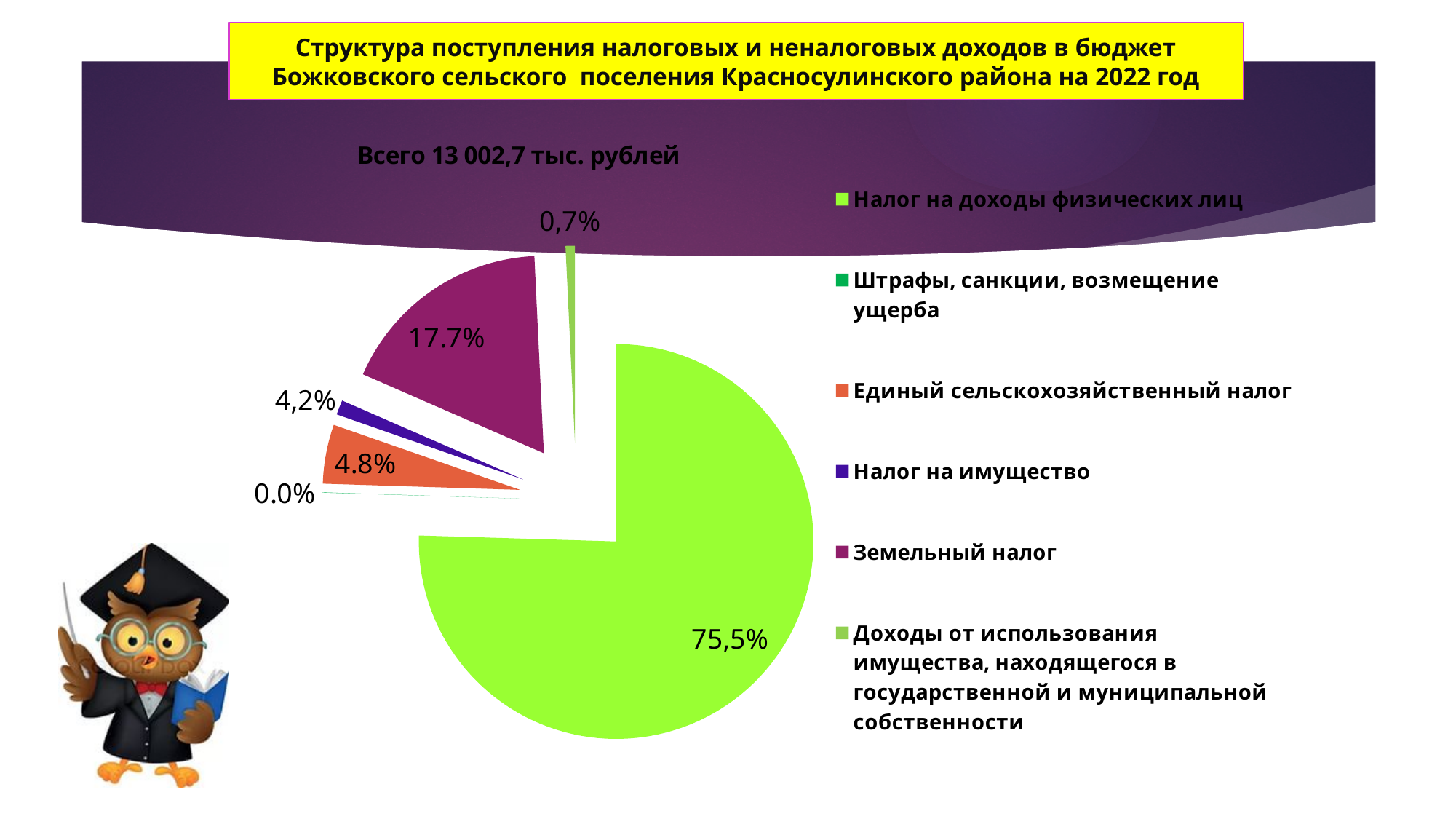
What kind of chart is shown on the slide? pie chart Which category has the largest share of the pie? Налог на доходы физических лиц What share of the pie does Налог на доходы физических лиц have? 75,5% What share of the pie does Единый сельскохозяйственный налог have? 4.8% Which category has the smallest share of the pie? Штрафы, санкции, возмещение ущерба What share of the pie does Доходы от использования имущества, находящегося в государственной и муниципальной собственности have? 0,7% How many categories does the legend list? 6 Which is larger: the share for Земельный налог or the share for Единый сельскохозяйственный налог? Земельный налог What total amount is stated above the pie chart? Всего 13 002,7 тыс. рублей